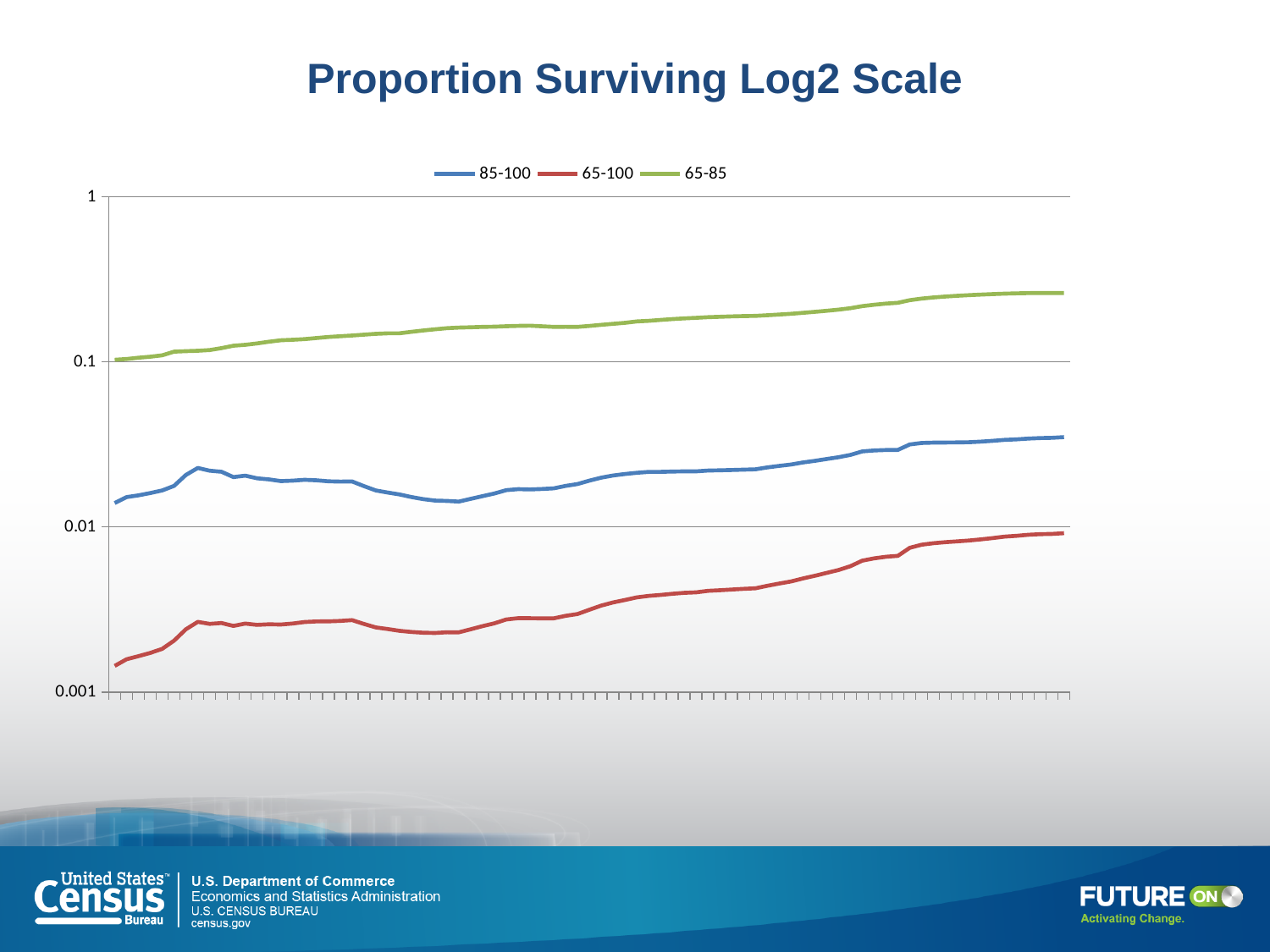
Is the 65-100 series greater or less than 0.01 at the right end of the chart? less Is the 65-100 series greater or less than 0.01 at the left end of the chart? less Does the 65-100 series generally rise or fall from left to right? rise Which series has the highest values across the chart? 65-85 How many series does the legend list? 3 Which series is larger at the right end of the chart, 85-100 or 65-100? 85-100 What is the title of the chart? Proportion Surviving Log2 Scale Which series is drawn in green? 65-85 Is the 85-100 series greater or less than 0.01 at the left end of the chart? greater Which series has the lowest values across the chart? 65-100 What kind of chart is shown on the slide? line chart